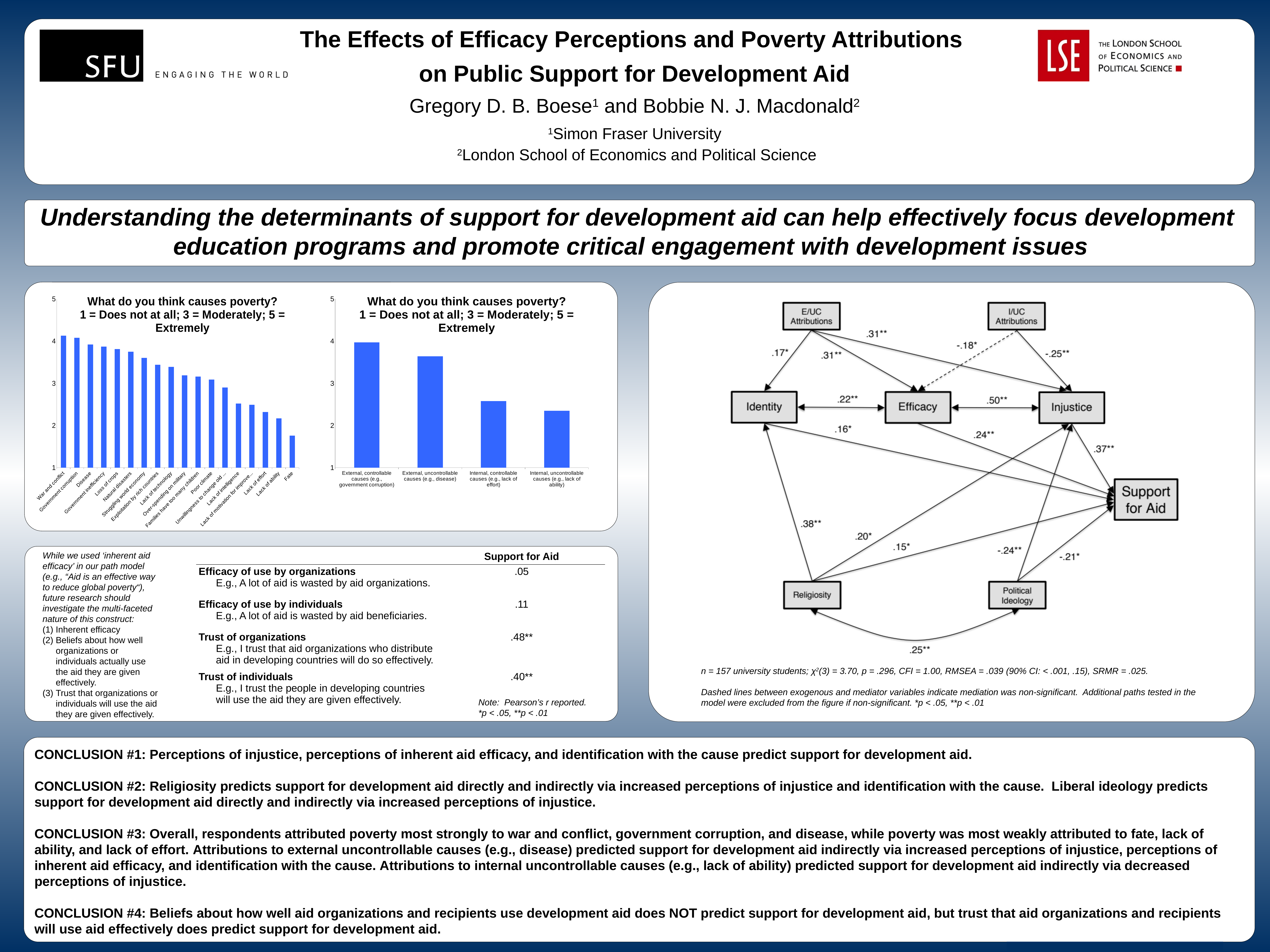
In the left chart, which cause of poverty has the lowest rating? Fate In the right chart, which category has the highest rating? External, controllable causes (e.g., government corruption) How many categories are plotted in the right chart? 4 In the left chart, is the value for Fate greater or less than 2? less What kind of chart is the left chart titled 'What do you think causes poverty?'? bar chart In the right chart, is the value for Internal, controllable causes (e.g., lack of effort) greater or less than 3? less In the right chart, which category has the lowest rating? Internal, uncontrollable causes (e.g., lack of ability) In the left chart, which cause of poverty has the highest rating? War and conflict In the left chart, do the bar values rise or fall from left to right along the x axis? fall What is the rating scale described in the title of the right chart? 1 = Does not at all; 3 = Moderately; 5 = Extremely In the left chart, which is larger: the value for War and conflict or the value for Lack of effort? War and conflict In the right chart, is the value for External, uncontrollable causes (e.g., disease) greater or less than 3? greater